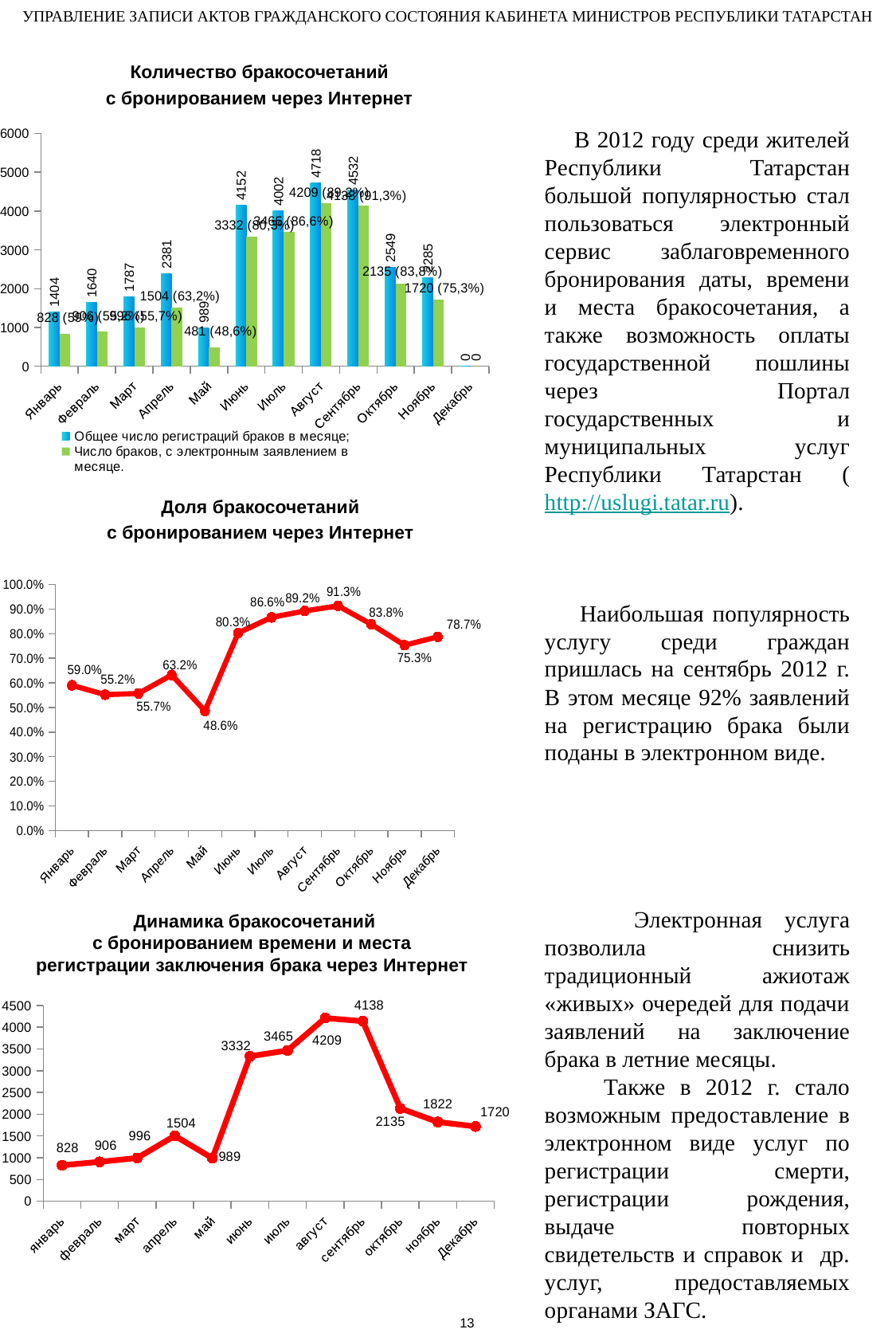
In the chart "Динамика бракосочетаний с бронированием времени и места регистрации заключения брака через Интернет", which is larger, the value for Август or the value for Сентябрь? Август In the chart "Динамика бракосочетаний с бронированием времени и места регистрации заключения брака через Интернет", how many months are plotted on the x axis? 12 What type of chart is "Количество бракосочетаний с бронированием через Интернет"? bar chart In the chart "Динамика бракосочетаний с бронированием времени и места регистрации заключения брака через Интернет", what is the value for Июль? 3465 In the chart "Доля бракосочетаний с бронированием через Интернет", which month has the lowest value? Май In the chart "Доля бракосочетаний с бронированием через Интернет", is the value for Ноябрь greater or less than 80.0%? less In the chart "Доля бракосочетаний с бронированием через Интернет", what is the value for Сентябрь? 91.3% In the chart "Количество бракосочетаний с бронированием через Интернет", which month has the highest total number of marriage registrations? Август In the chart "Количество бракосочетаний с бронированием через Интернет", what is the total number of marriage registrations in Август? 4718 In the chart "Доля бракосочетаний с бронированием через Интернет", what is the difference between the values for Сентябрь and Май? 42.7% In the chart "Количество бракосочетаний с бронированием через Интернет", how many series does the legend list? 2 In the chart "Динамика бракосочетаний с бронированием времени и места регистрации заключения брака через Интернет", do the values rise or fall from Сентябрь to Декабрь? fall